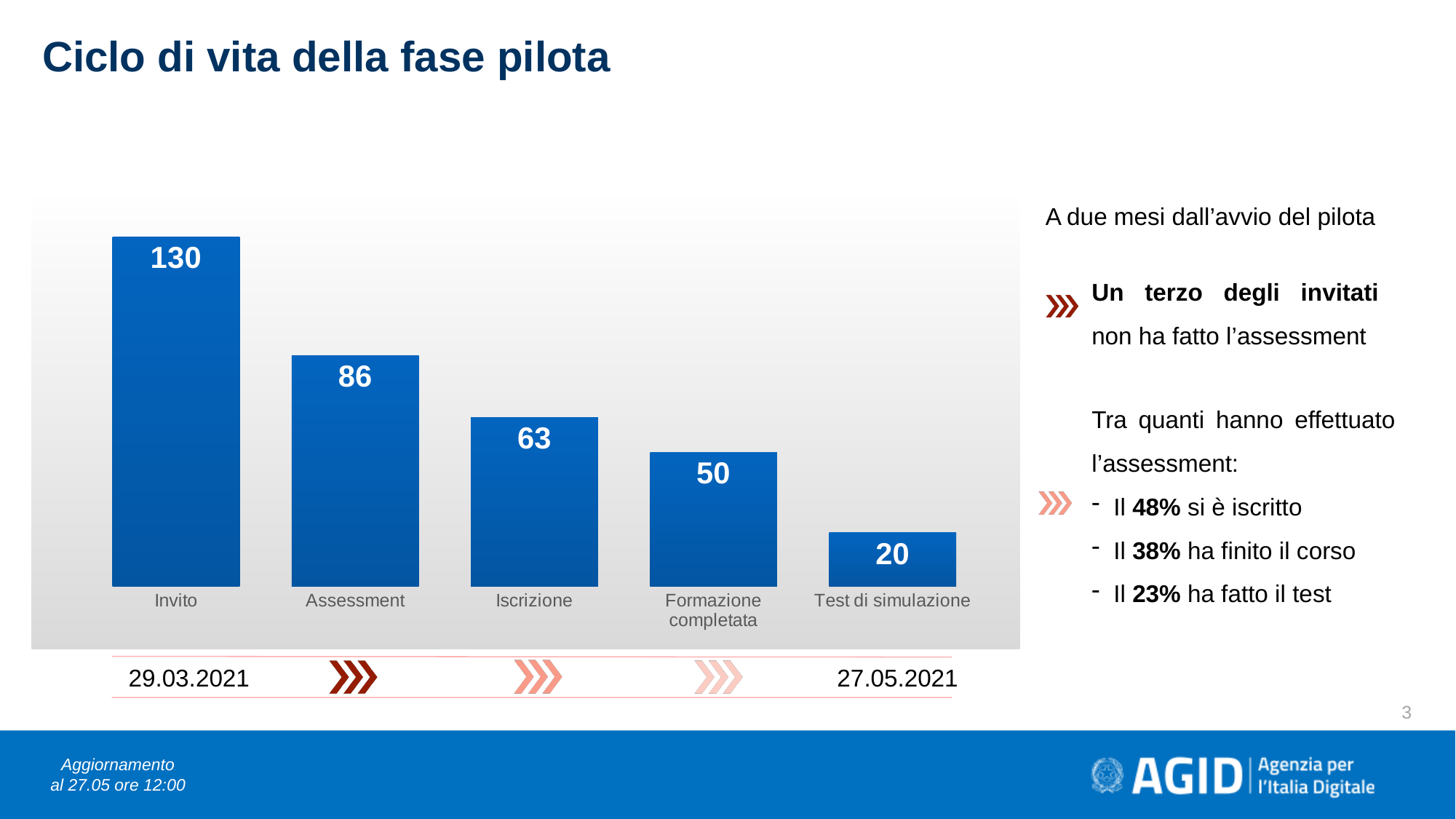
Which is larger, the value for Iscrizione or the value for Formazione completata? Iscrizione How many categories are shown in the chart? 5 Which category has the lowest value? Test di simulazione What is the value for Iscrizione? 63 What is the value for Invito? 130 Which category has the highest value? Invito What is the value for Test di simulazione? 20 What is the value for Assessment? 86 What kind of chart is shown on the slide? Bar chart What is the difference between the values for Invito and Assessment? 44 What is the value for Formazione completata? 50 Do the values rise or fall from left to right across the categories? Fall